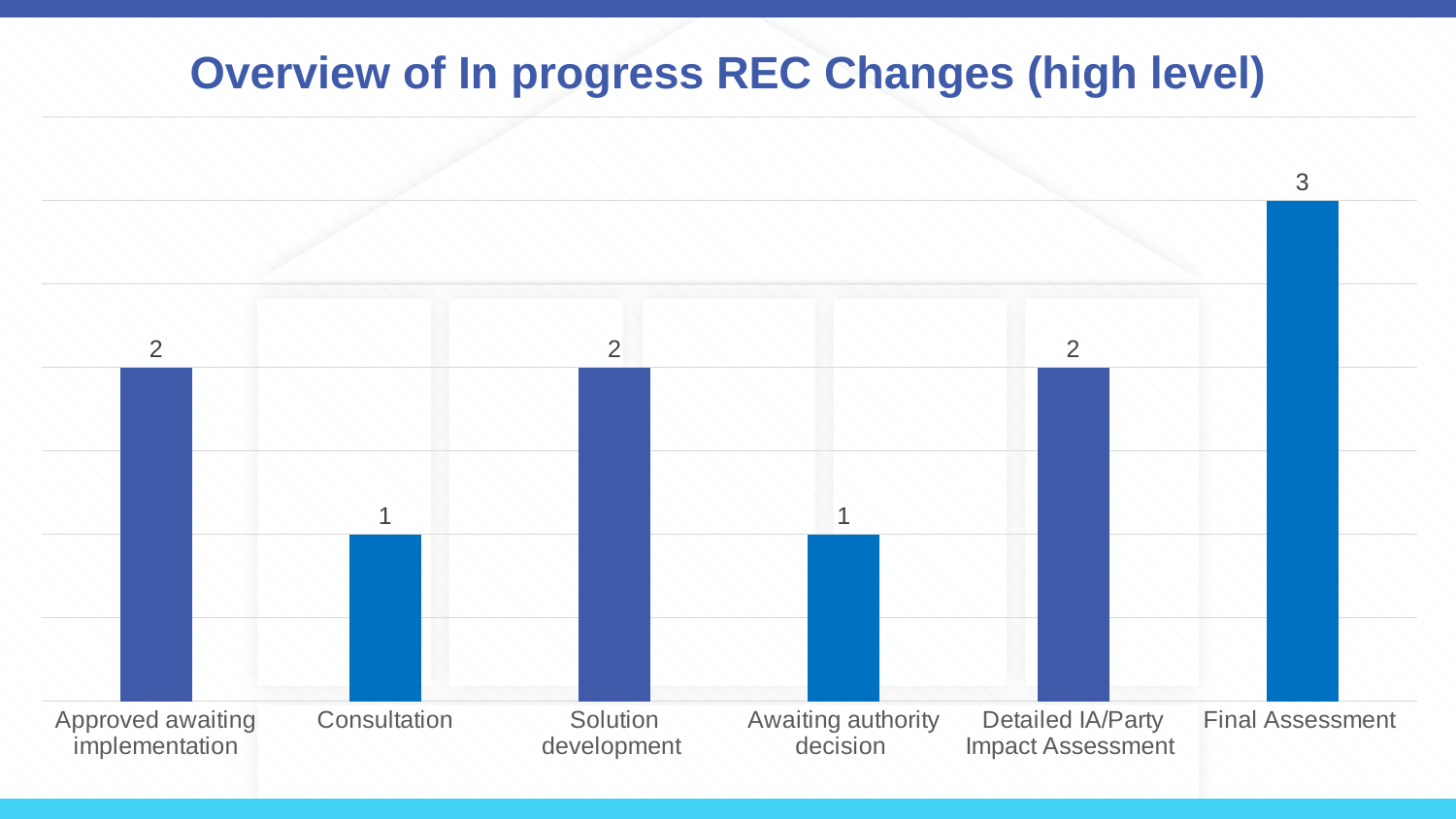
How many categories have a value of 2? 3 What kind of chart is shown on the slide? Bar chart What is the value for Awaiting authority decision? 1 Which is larger, the value for Approved awaiting implementation or the value for Consultation? Approved awaiting implementation What is the value for Final Assessment? 3 What is the value for Consultation? 1 What is the title of the chart? Overview of In progress REC Changes (high level) What is the value for Detailed IA/Party Impact Assessment? 2 Which category has the highest value? Final Assessment What is the difference between the values for Solution development and Awaiting authority decision? 1 How many categories are shown on the x axis? 6 What is the difference between the values for Final Assessment and Consultation? 2